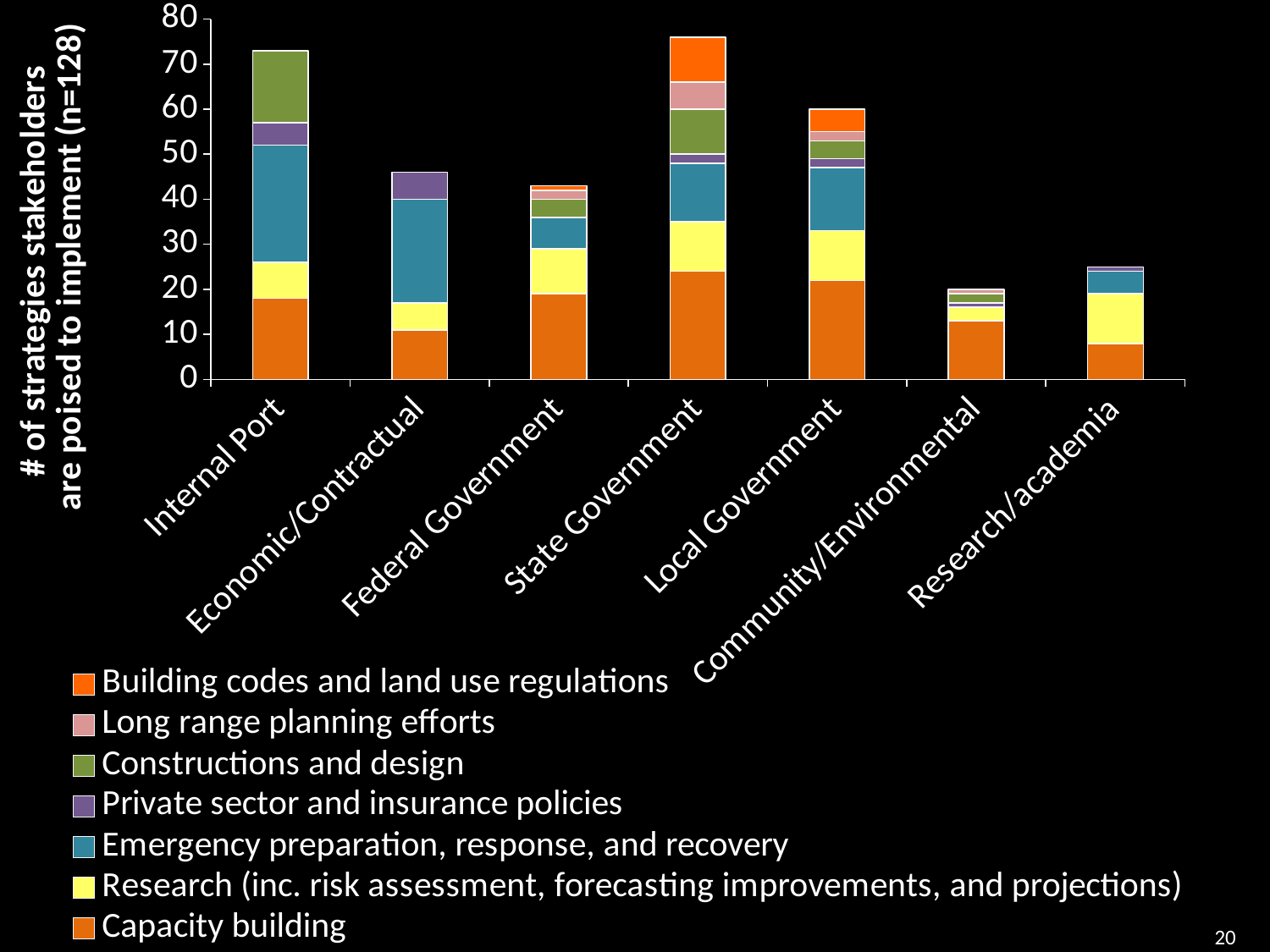
Which has the taller stacked bar, Internal Port or Economic/Contractual? Internal Port What kind of chart is shown on the slide? stacked bar chart Is the total bar for Economic/Contractual greater or less than 50? less Which has the taller stacked bar, Local Government or Federal Government? Local Government How many stakeholder categories are shown on the x axis? 7 Is the total bar for Research/academia greater or less than 30? less Is the total bar for Internal Port greater or less than 60? greater Which stakeholder category has the shortest stacked bar? Community/Environmental What is the title of the y axis? # of strategies stakeholders are poised to implement (n=128) How many series does the legend list? 7 Which stakeholder category has the tallest stacked bar? State Government